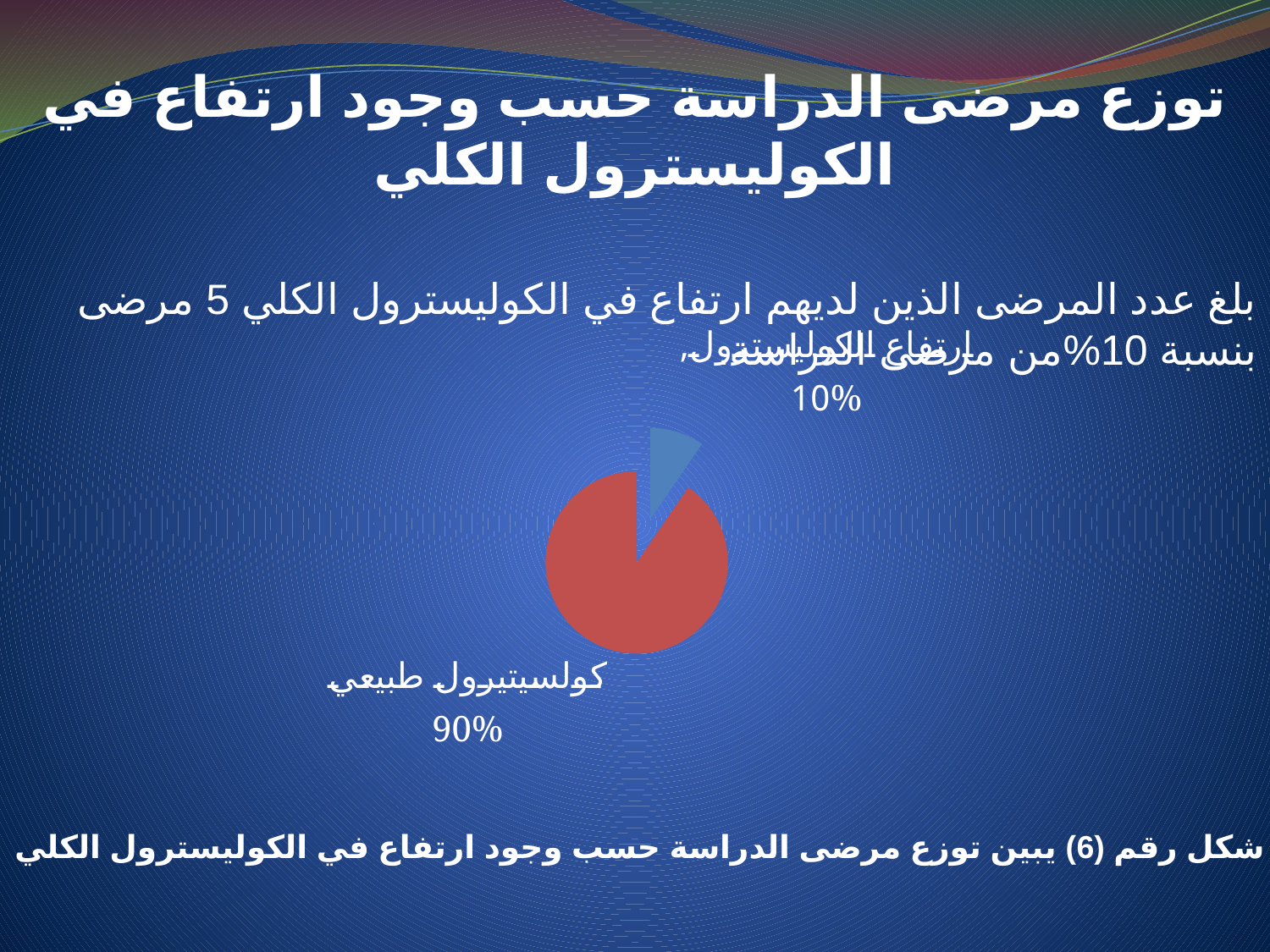
What colour is the slice labelled "ارتفاع الكوليسترول"? blue Which slice of the pie chart is the smallest? ارتفاع الكوليسترول What is the difference in percentage points between the "كولسيتيرول طبيعي" slice and the "ارتفاع الكوليسترول" slice? 80 What colour is the slice labelled "كولسيتيرول طبيعي"? red How many slices does the pie chart have? 2 What kind of chart is shown on the slide? pie chart Which slice of the pie chart is the largest? كولسيتيرول طبيعي What share of the pie does the slice labelled "كولسيتيرول طبيعي" represent? 90% What share of the pie does the slice labelled "ارتفاع الكوليسترول" represent? 10% Which is larger: the "كولسيتيرول طبيعي" slice or the "ارتفاع الكوليسترول" slice? كولسيتيرول طبيعي